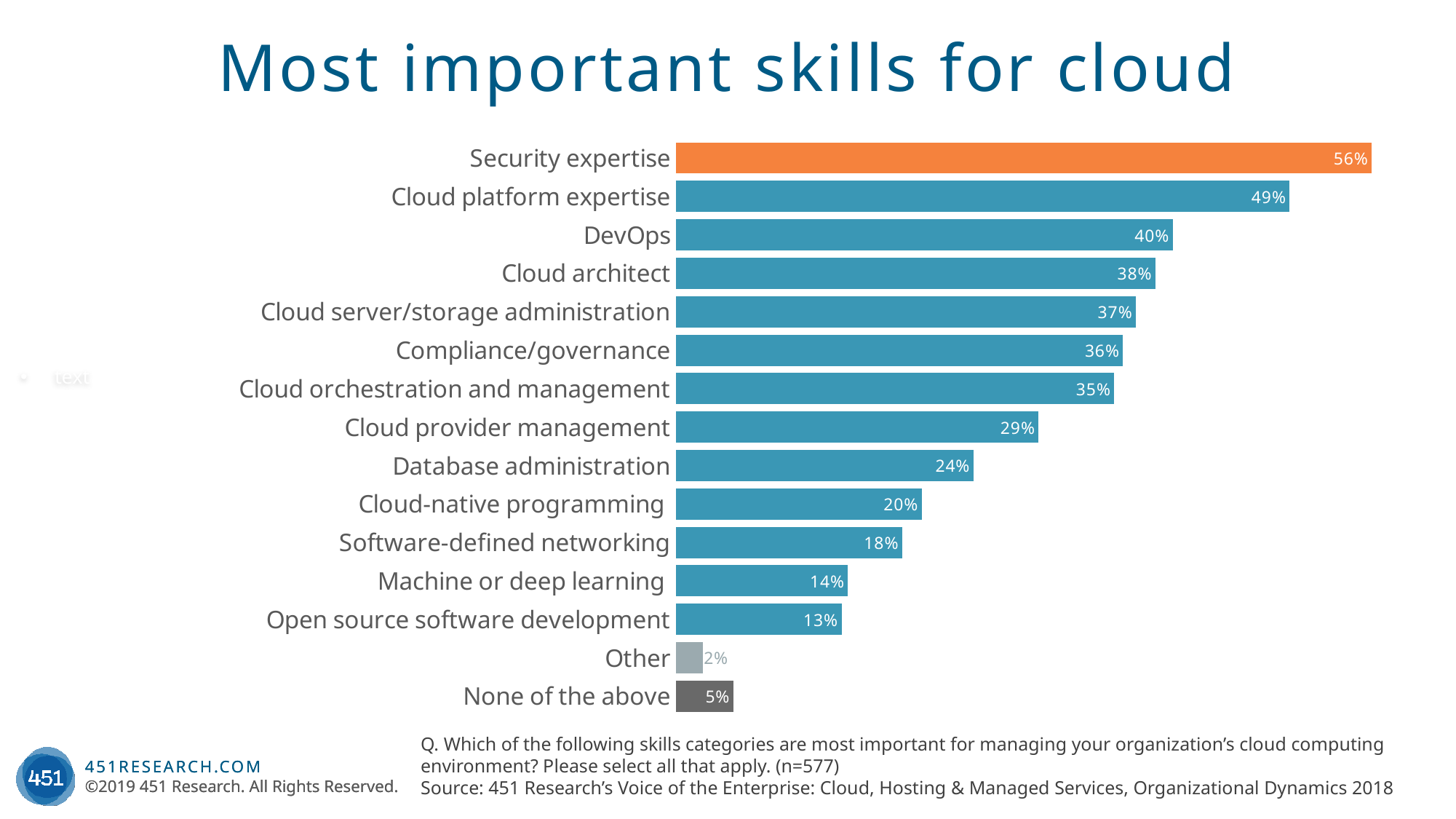
How many categories are shown on the chart? 15 What is the value shown for DevOps? 40% Which bar is highlighted in orange? Security expertise Which has a larger value, Software-defined networking or Cloud-native programming? Cloud-native programming What is the difference between the values for Security expertise and Cloud platform expertise? 7% What type of chart is shown on the slide? Bar chart What is the difference between the values for Cloud provider management and Database administration? 5% What percentage is shown for Machine or deep learning? 14% Which has a larger value, Compliance/governance or Cloud orchestration and management? Compliance/governance Which category has the lowest value on the chart? Other Which skill category has the highest value on the chart? Security expertise What percentage of respondents selected Security expertise as a most important skill for cloud? 56%